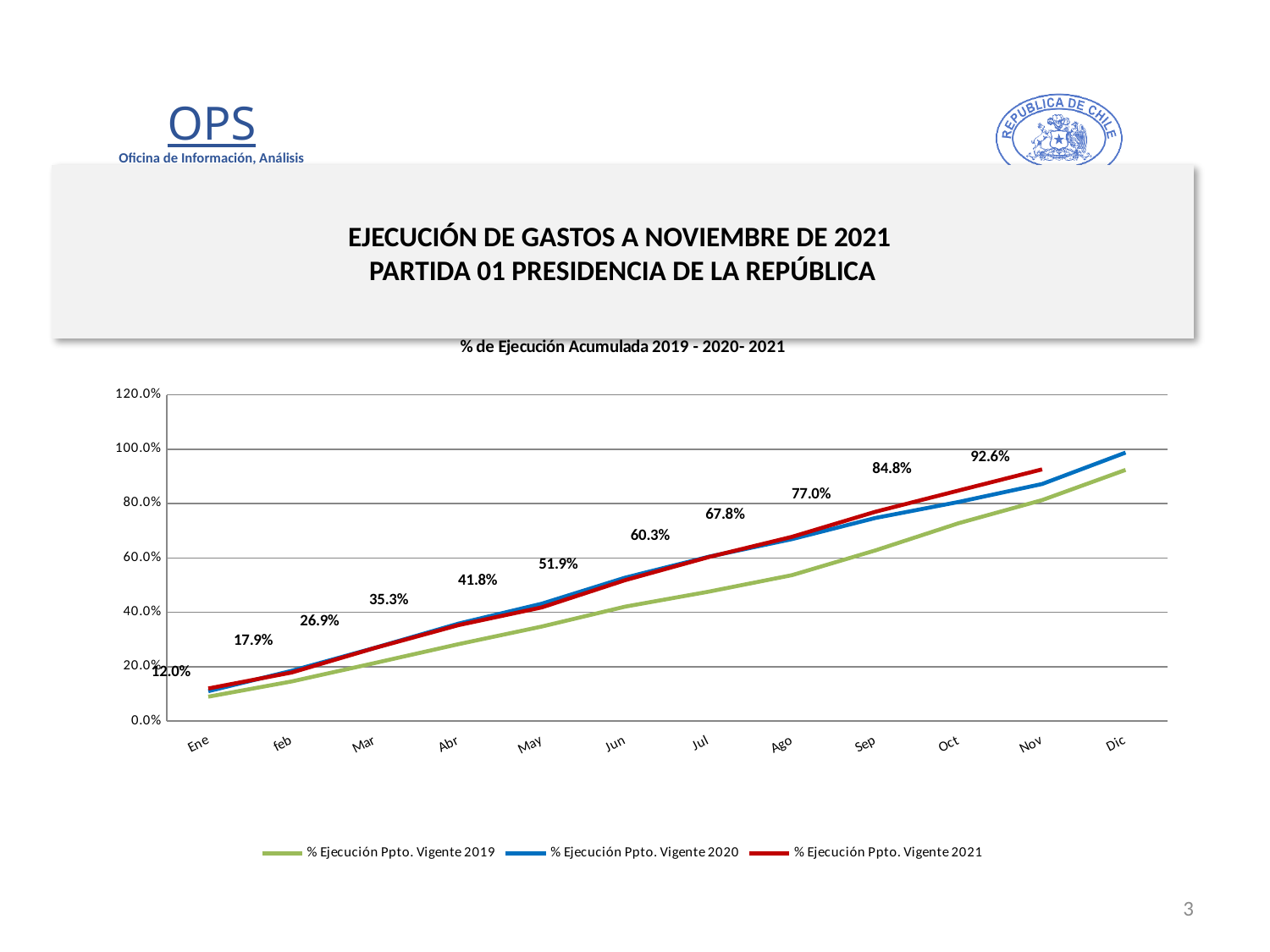
How many months are shown along the x axis? 12 What is the value of % Ejecución Ppto. Vigente 2021 for Jun? 51.9% What is the title of the chart? % de Ejecución Acumulada 2019 - 2020- 2021 What is the value of % Ejecución Ppto. Vigente 2021 for Ene? 12.0% Is the value of % Ejecución Ppto. Vigente 2019 for Dic greater or less than 100.0%? less What type of chart is shown on the slide? line chart How many series does the legend list? 3 What is the difference between the 2021 values for Nov and Oct? 7.8% In which month does the % Ejecución Ppto. Vigente 2021 series reach its highest labelled value? Nov What is the value of % Ejecución Ppto. Vigente 2021 for Nov? 92.6% Do the values of the % Ejecución Ppto. Vigente 2021 series rise or fall from Ene to Nov? rise What is the value of % Ejecución Ppto. Vigente 2021 for Sep? 77.0%